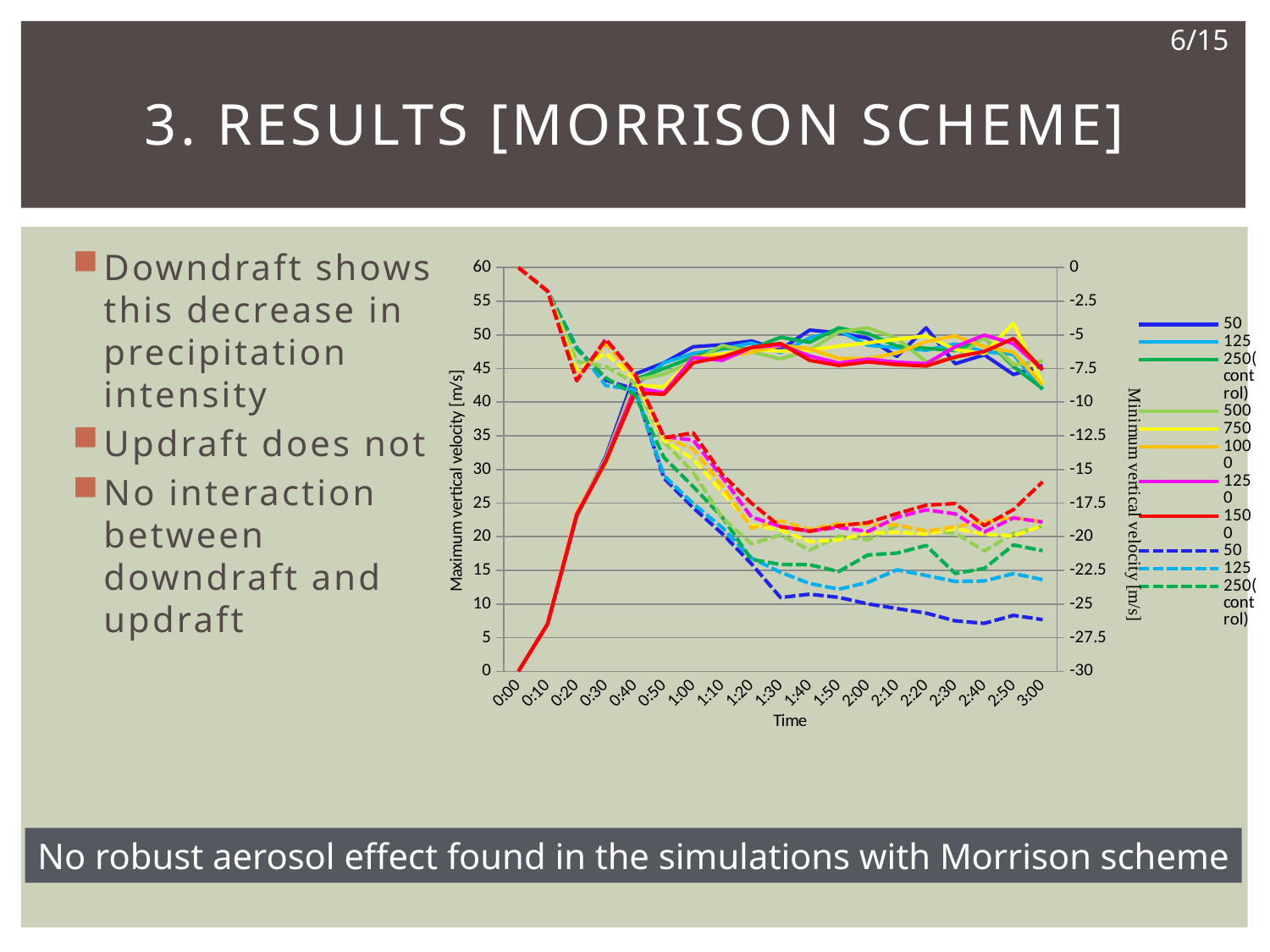
What kind of chart is shown on the slide? line chart Is the value of the solid red 1500 line at 0:10 greater or less than 10? less Is the value of the dashed blue 50 line at 1:00, read on the right axis, greater or less than -20? greater What is the title of the right vertical axis of the chart? Minimum vertical velocity [m/s] How many time points are labelled along the x axis of the chart? 19 What is the lowest tick value shown on the right vertical axis? -30 Is the value of the solid blue 50 line at 2:00 greater or less than 40? greater What is the title of the left vertical axis of the chart? Maximum vertical velocity [m/s] What is the value of the solid red 1500 line at 0:00? 0 Is the value of the solid blue 50 line larger at 0:10 or at 1:30? 1:30 Do the solid lines rise or fall between 0:00 and 1:00? rise What is the highest tick value shown on the left vertical axis? 60